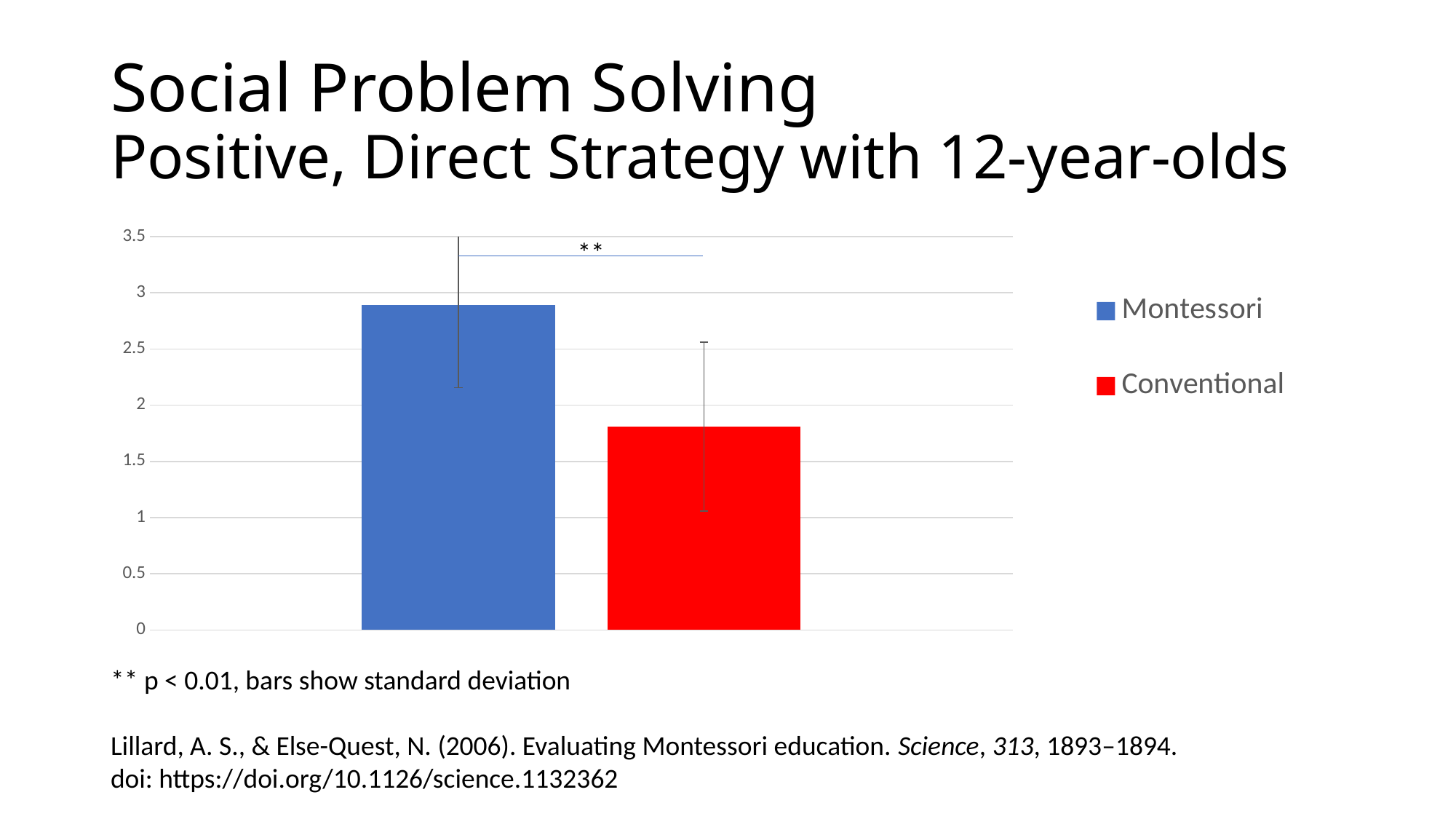
Is the value for Conventional greater or less than 1.5? greater Is the value for Montessori larger or smaller than the value for Conventional? larger How many series does the legend list? 2 Which group has the lowest bar? Conventional Which group has the highest bar, Montessori or Conventional? Montessori What kind of chart is shown on the slide? bar chart According to the footnote, what do the error bars on the chart show? standard deviation How many bars are plotted in the chart? 2 What colour is the Montessori bar? blue Is the value for Montessori greater or less than 2.5? greater Is the value for Conventional greater or less than 2? less